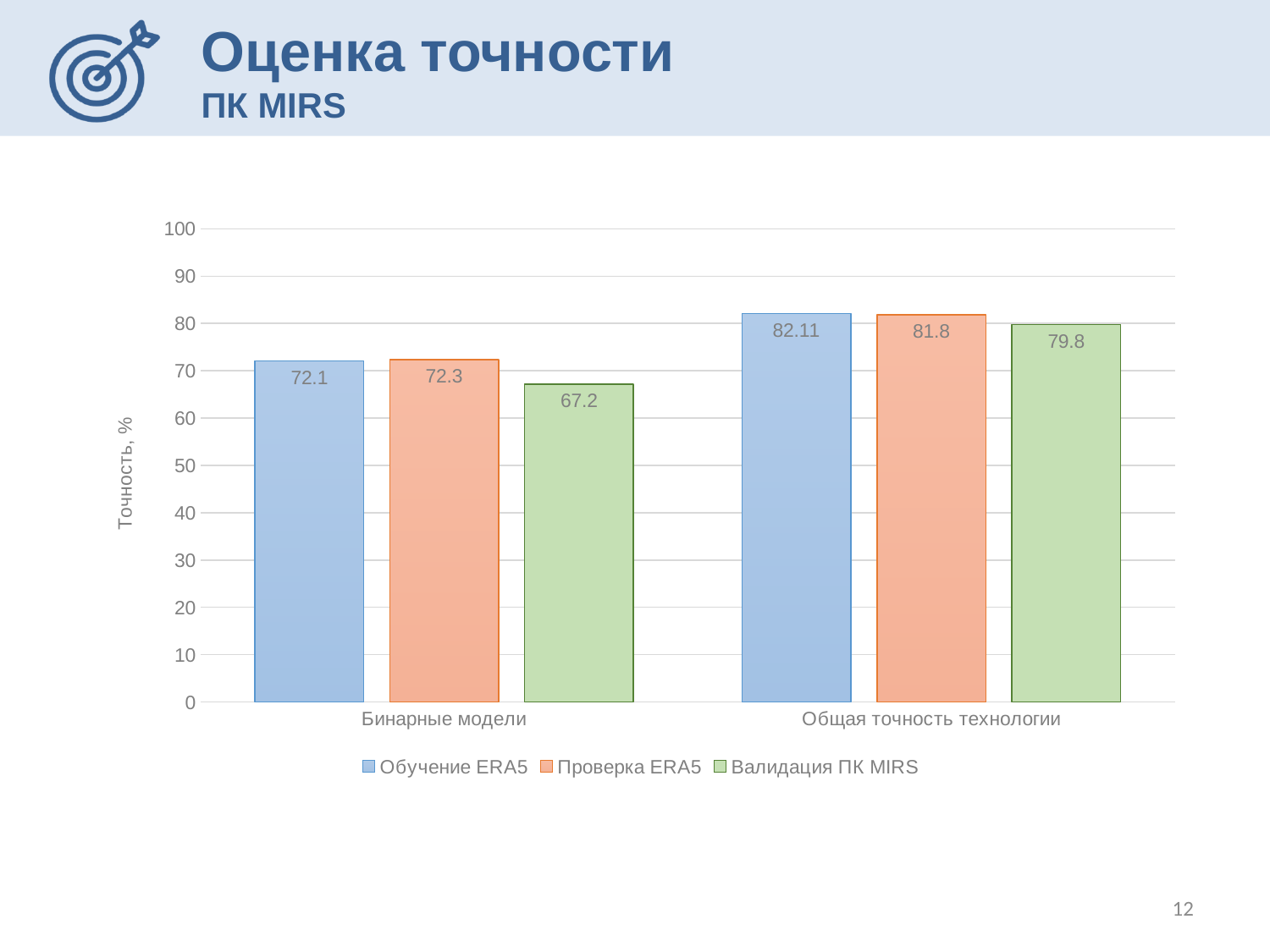
What is the value for Валидация ПК MIRS in the Общая точность технологии category? 79.8 What is the difference between the Обучение ERA5 value and the Валидация ПК MIRS value in the Бинарные модели category? 4.9 Which series has the lowest value in the Бинарные модели category? Валидация ПК MIRS How many series does the legend list? 3 Is the value for Обучение ERA5 in the Общая точность технологии category greater or less than 80? greater What is the value for Валидация ПК MIRS in the Бинарные модели category? 67.2 What is the value for Проверка ERA5 in the Общая точность технологии category? 81.8 What is the value for Обучение ERA5 in the Бинарные модели category? 72.1 Which series has the highest value in the Общая точность технологии category? Обучение ERA5 Which is larger: the Валидация ПК MIRS value for Бинарные модели or for Общая точность технологии? Общая точность технологии What kind of chart is shown on the slide? bar chart How many categories are shown on the x axis? 2